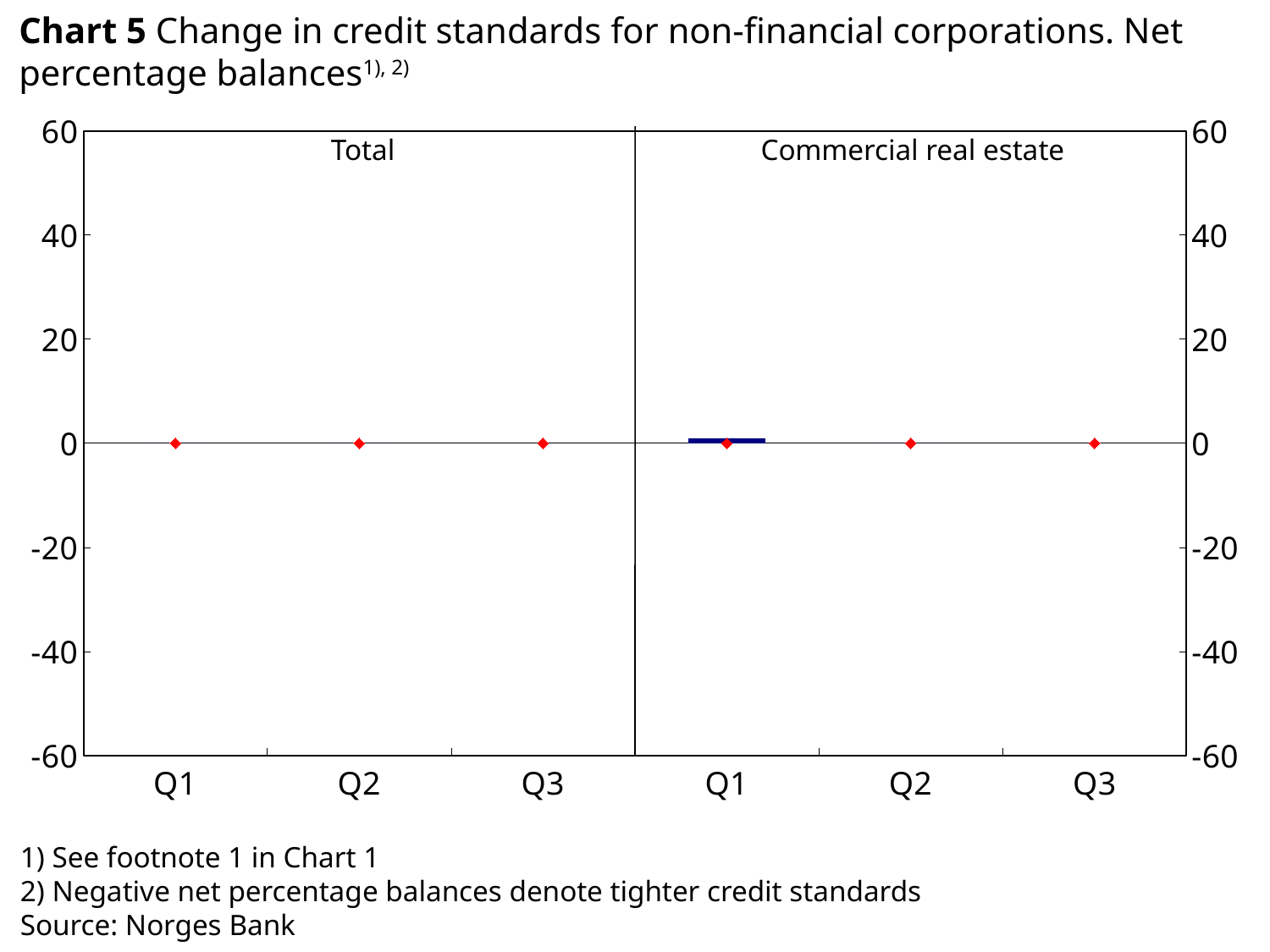
In the Total panel, is the value for Q2 greater or less than 40? less What is the lowest value shown on the vertical axis? -60 What are the two panels of the chart labelled? Total and Commercial real estate How many quarters are shown on the x axis of the Commercial real estate panel? 3 What is the highest value shown on the vertical axis? 60 In the Commercial real estate panel, is the bar for Q1 greater or less than 20? less Which panel of the chart contains a visible blue bar? Commercial real estate What kind of chart is shown on the slide? bar chart In the Total panel, is the value for Q3 greater or less than -40? greater How many quarters are shown on the x axis of the Total panel? 3